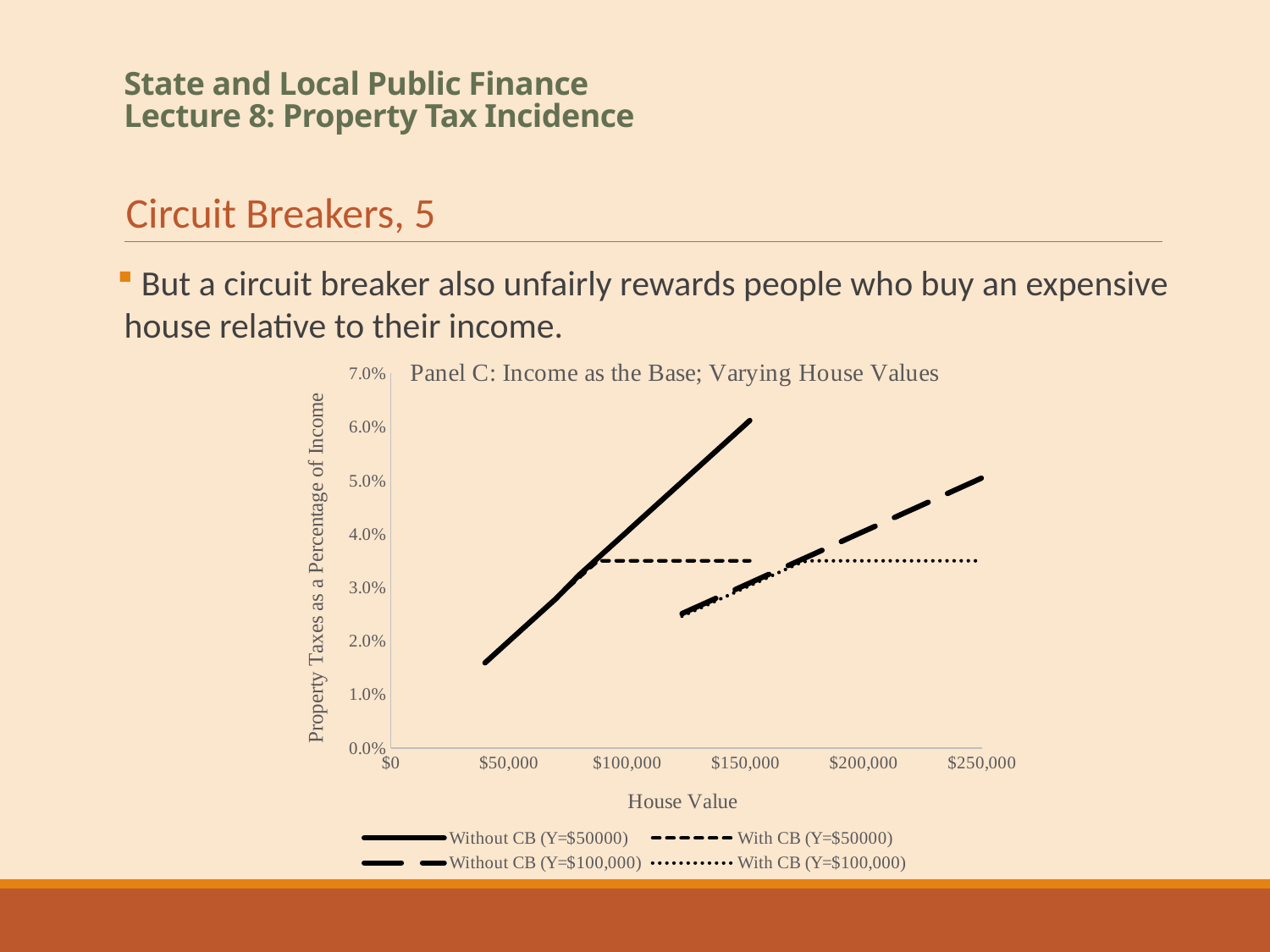
Is the value of the Without CB (Y=$50000) series at a house value of $100,000 greater or less than 3.0%? greater How many series does the legend list? 4 Is the value of the Without CB (Y=$100,000) series at a house value of $250,000 greater or less than 4.0%? greater What is the title of the chart? Panel C: Income as the Base; Varying House Values Which series reaches the highest value on the chart? Without CB (Y=$50000) What is the highest tick value shown on the vertical axis? 7.0% Is the value of the With CB (Y=$50000) series at a house value of $150,000 greater or less than 3.0%? greater At a house value of $150,000, which series has the larger value: Without CB (Y=$50000) or With CB (Y=$50000)? Without CB (Y=$50000) What is the label of the vertical axis? Property Taxes as a Percentage of Income Does the Without CB (Y=$50000) series rise or fall as house value increases? rise What kind of chart is shown on the slide? line chart